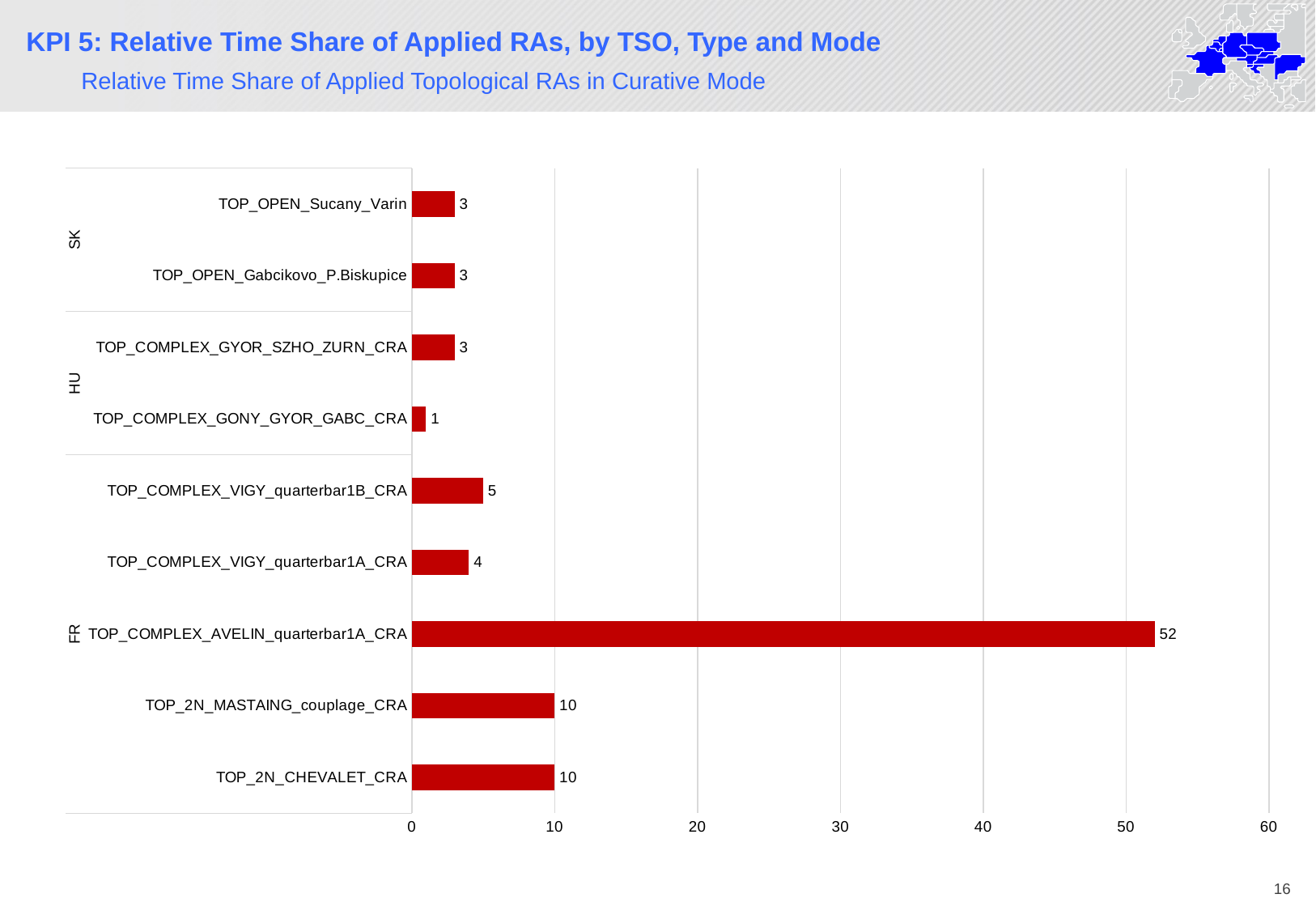
What is the value for TOP_COMPLEX_GONY_GYOR_GABC_CRA? 1 Which category has the lowest value? TOP_COMPLEX_GONY_GYOR_GABC_CRA What is the value for TOP_COMPLEX_VIGY_quarterbar1B_CRA? 5 Which is larger, the value for TOP_COMPLEX_VIGY_quarterbar1B_CRA or TOP_COMPLEX_VIGY_quarterbar1A_CRA? TOP_COMPLEX_VIGY_quarterbar1B_CRA What is the title of the chart? Relative Time Share of Applied Topological RAs in Curative Mode What is the value for TOP_2N_MASTAING_couplage_CRA? 10 What is the value for TOP_COMPLEX_AVELIN_quarterbar1A_CRA? 52 Which category has the highest value? TOP_COMPLEX_AVELIN_quarterbar1A_CRA How many categories are shown in the chart? 9 What is the difference between the values for TOP_COMPLEX_AVELIN_quarterbar1A_CRA and TOP_2N_CHEVALET_CRA? 42 What kind of chart is shown on the slide? bar chart Is the value for TOP_COMPLEX_AVELIN_quarterbar1A_CRA greater or less than 50? greater